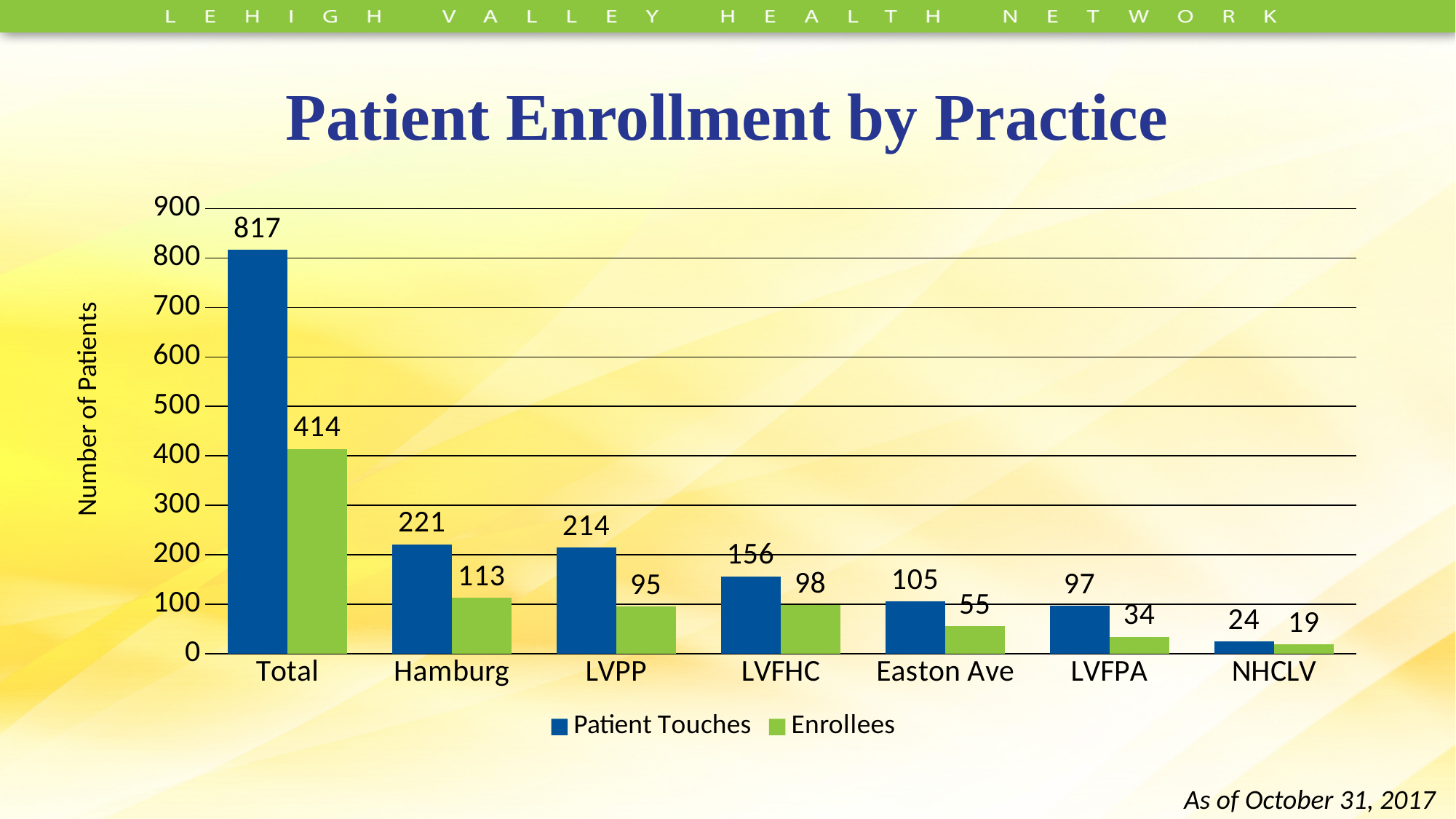
Is the value of Patient Touches for LVFHC greater or less than 200? less What is the difference between Patient Touches and Enrollees for Easton Ave? 50 What kind of chart is shown on the slide? Bar chart How many categories are shown on the x axis? 7 How many series does the legend list? 2 Which practice has the lowest number of Enrollees? NHCLV What is the number of Enrollees for Total? 414 What is the number of Enrollees for LVFHC? 98 Which is larger: Enrollees for LVPP or Enrollees for LVFHC? Enrollees for LVFHC What is the number of Patient Touches for Hamburg? 221 Excluding the Total category, which practice has the highest number of Patient Touches? Hamburg What is the label of the y axis? Number of Patients